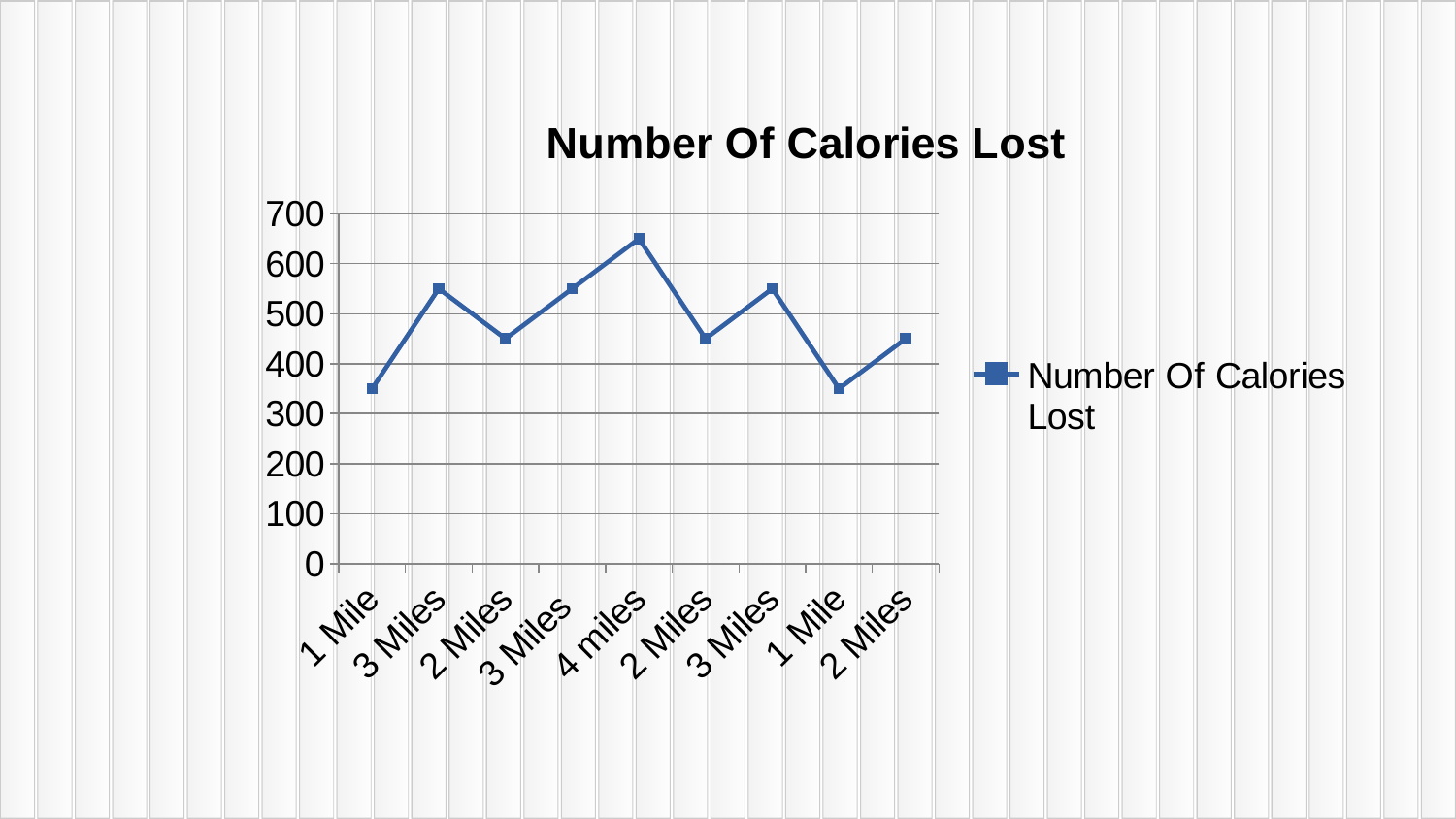
Which category has the highest value? 4 miles Is the value for the first 1 Mile point greater or less than 400? less What kind of chart is shown on the slide? line chart What is the highest value shown on the vertical axis? 700 Which is larger, the value for 4 miles or the value for the first 3 Miles point? 4 miles How many data points are plotted on the line? 9 How many series does the legend list? 1 Does the value rise or fall from 4 miles to the next point (2 Miles)? fall Is the value for 4 miles greater or less than 600? greater Is the value for the last point (2 Miles) greater or less than 500? less What is the title of the chart? Number Of Calories Lost Which is larger, the value for the first point (1 Mile) or the second point (3 Miles)? 3 Miles